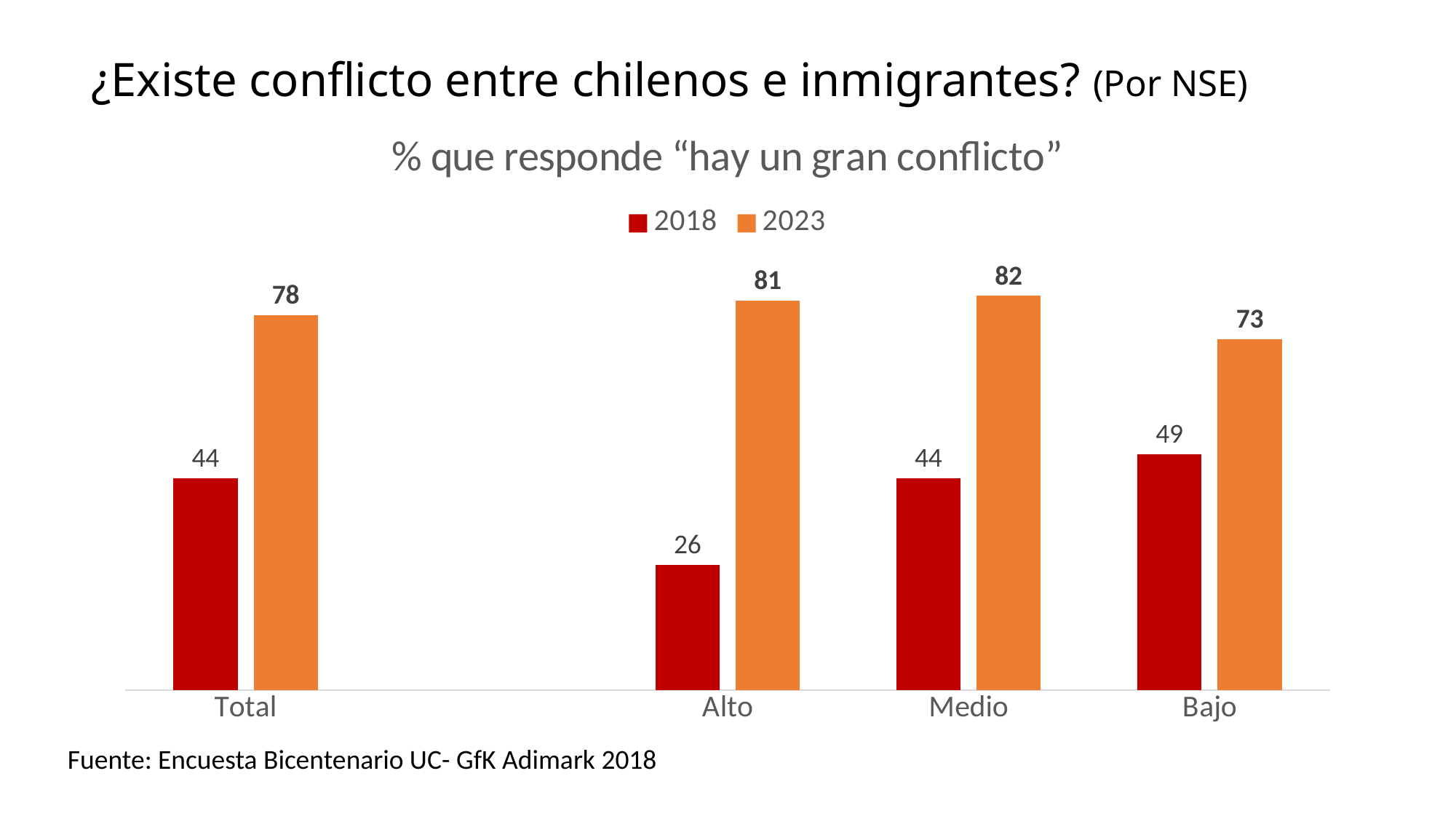
What is the 2023 value for Alto? 81 What kind of chart is shown? Bar chart How many categories are shown on the x axis? 4 Which colour represents the 2023 series? Orange Which category has the lowest 2018 value? Alto What is the difference between the 2023 values for Medio and Bajo? 9 Which category has the highest 2023 value? Medio What is the 2018 value for Total? 44 What is the 2018 value for Bajo? 49 What is the difference between the 2023 and 2018 values for Alto? 55 Which is larger, the 2018 value for Bajo or the 2018 value for Medio? Bajo How many series does the legend list? 2